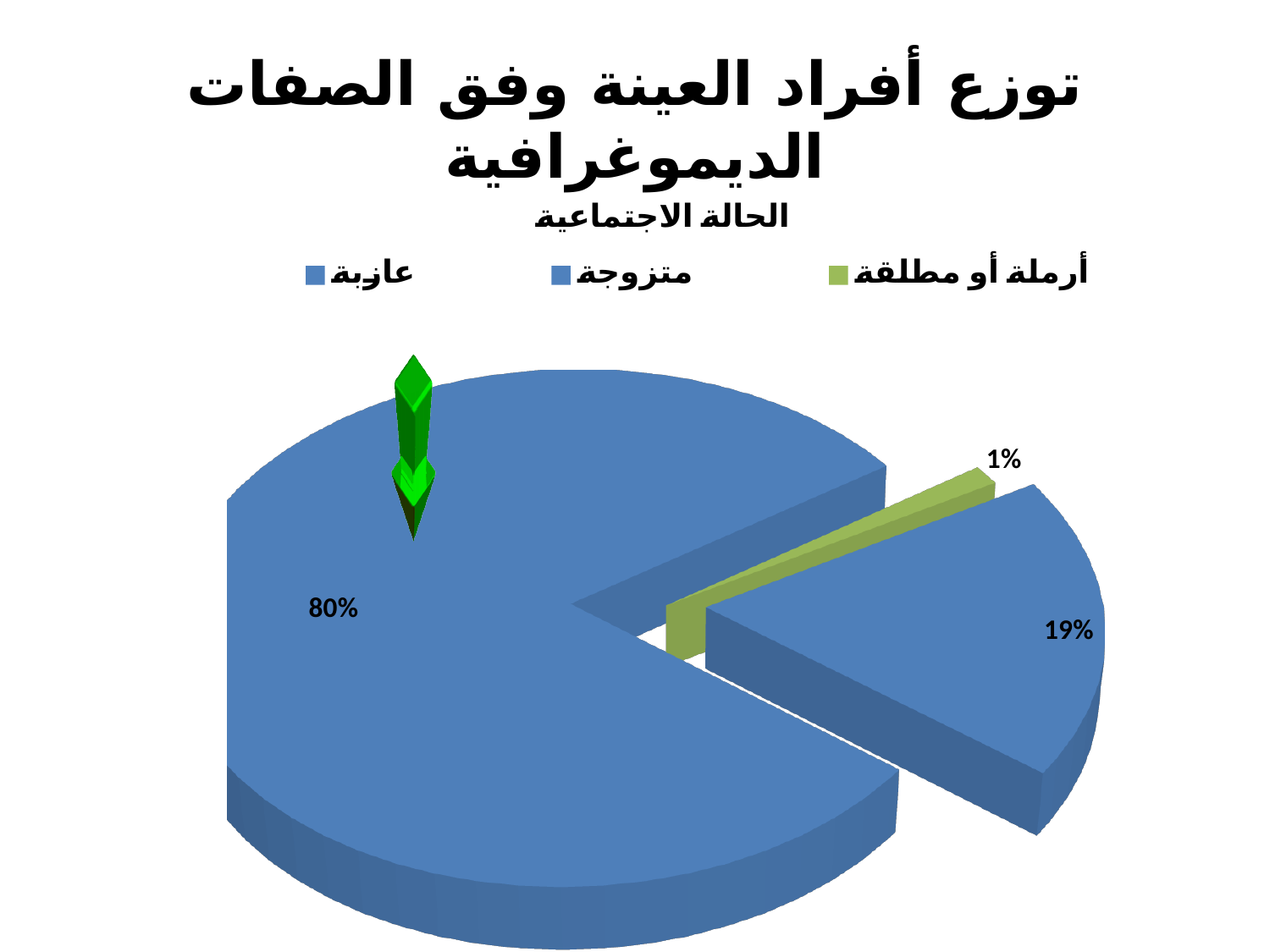
What is the difference between the 19% slice and the 1% slice? 18% What colour is the أرملة أو مطلقة slice? green What percentage is shown for the أرملة أو مطلقة slice? 1% What is the largest percentage shown on the pie chart? 80% Which is larger, the 80% slice or the 19% slice? the 80% slice What is the title of the chart? الحالة الاجتماعية How many categories does the legend list? 3 How many slices does the pie chart have? 3 Which category has the smallest share of the pie? أرملة أو مطلقة What is the difference between the largest slice (80%) and the 19% slice? 61% What kind of chart is shown on the slide? pie chart What is the smallest percentage shown on the pie chart? 1%